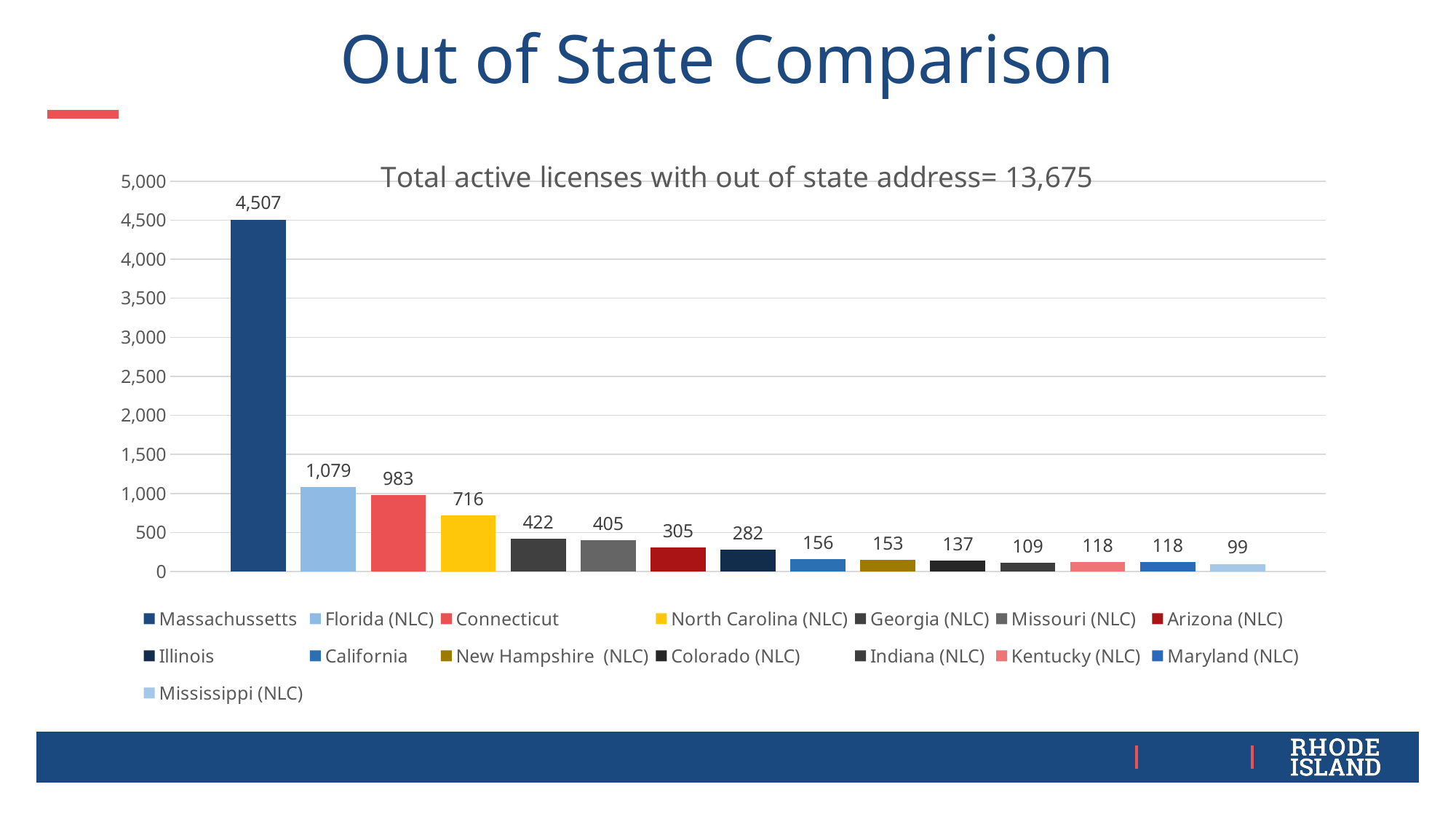
Is the value for Arizona (NLC) greater or less than 500? less Which state has the highest value? Massachussetts Which is larger, the value for Georgia (NLC) or the value for Missouri (NLC)? Georgia (NLC) What is the value for Illinois? 282 What is the difference between the values for Connecticut and North Carolina (NLC)? 267 What kind of chart is shown on the slide? bar chart What is the value for Florida (NLC)? 1,079 Which state has the lowest value? Mississippi (NLC) What is the value for Massachussetts? 4,507 What is the value for North Carolina (NLC)? 716 What total is stated in the chart's title? 13,675 How many bars are plotted in the chart? 15